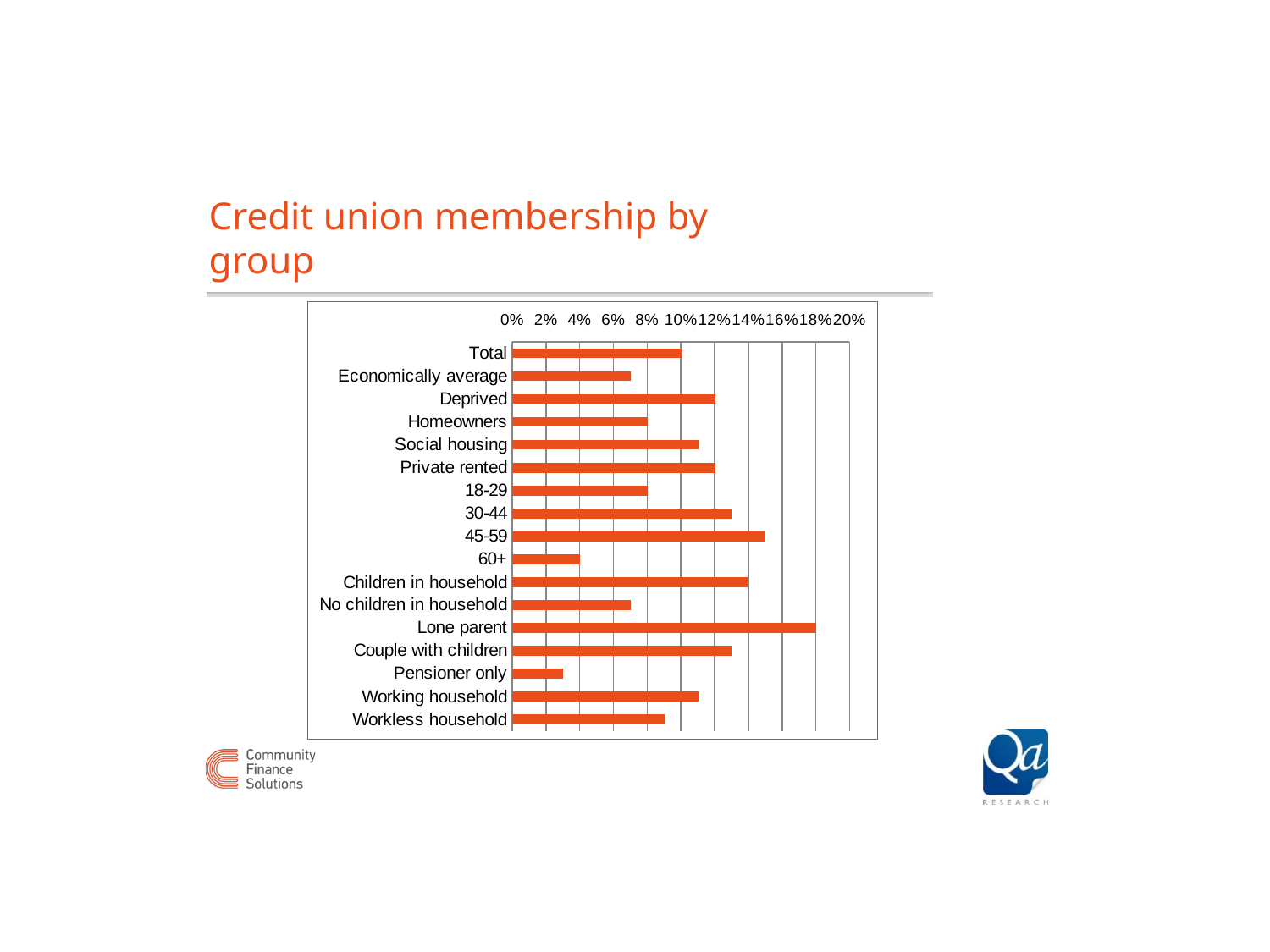
Is the value for 45-59 greater or less than 14%? greater Is the value for Total greater or less than 8%? greater Which is larger, the value for 45-59 or the value for 60+? 45-59 Is the value for Pensioner only greater or less than 4%? less Which is larger, the value for Children in household or the value for No children in household? Children in household Which group has the lowest credit union membership? Pensioner only How many groups (categories) are plotted in the chart? 17 What kind of chart is shown on the slide? bar chart Which group has the highest credit union membership? Lone parent What is the title of the slide containing the chart? Credit union membership by group